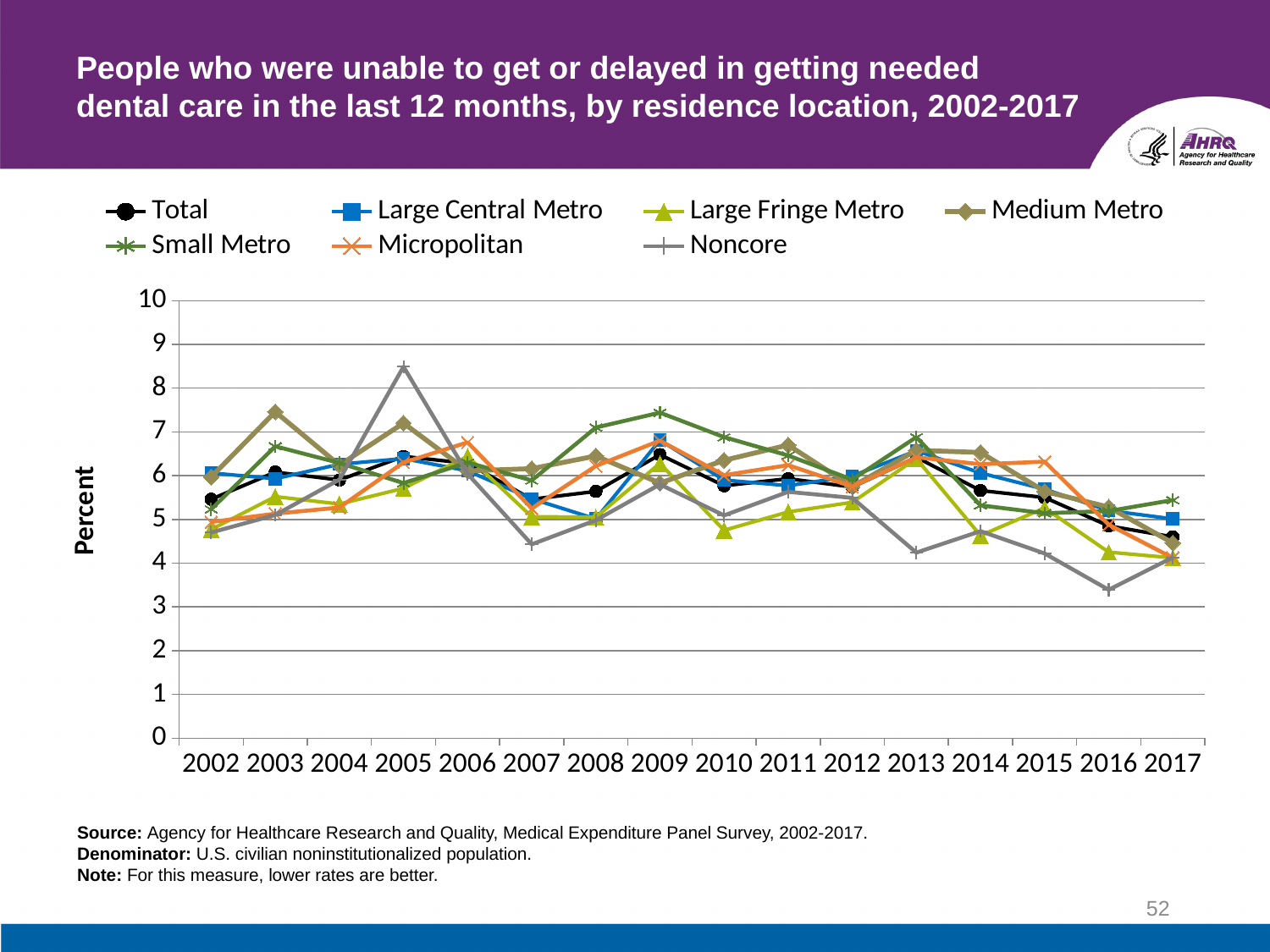
What kind of chart is shown on the slide? line chart How many years are shown along the x axis? 16 Does the Total series rise or fall from 2013 to 2017? fall Which series has the highest value in 2003? Medium Metro What is the label on the y axis? Percent In which year does the Noncore series reach its highest value? 2005 How many series does the legend list? 7 Is the value for Medium Metro in 2003 greater or less than 7? greater Is the value for Noncore in 2005 greater or less than 8? greater Which series has the lowest value in 2016? Noncore Is the value for Noncore in 2016 greater or less than 4? less Which series has the highest value in 2005? Noncore